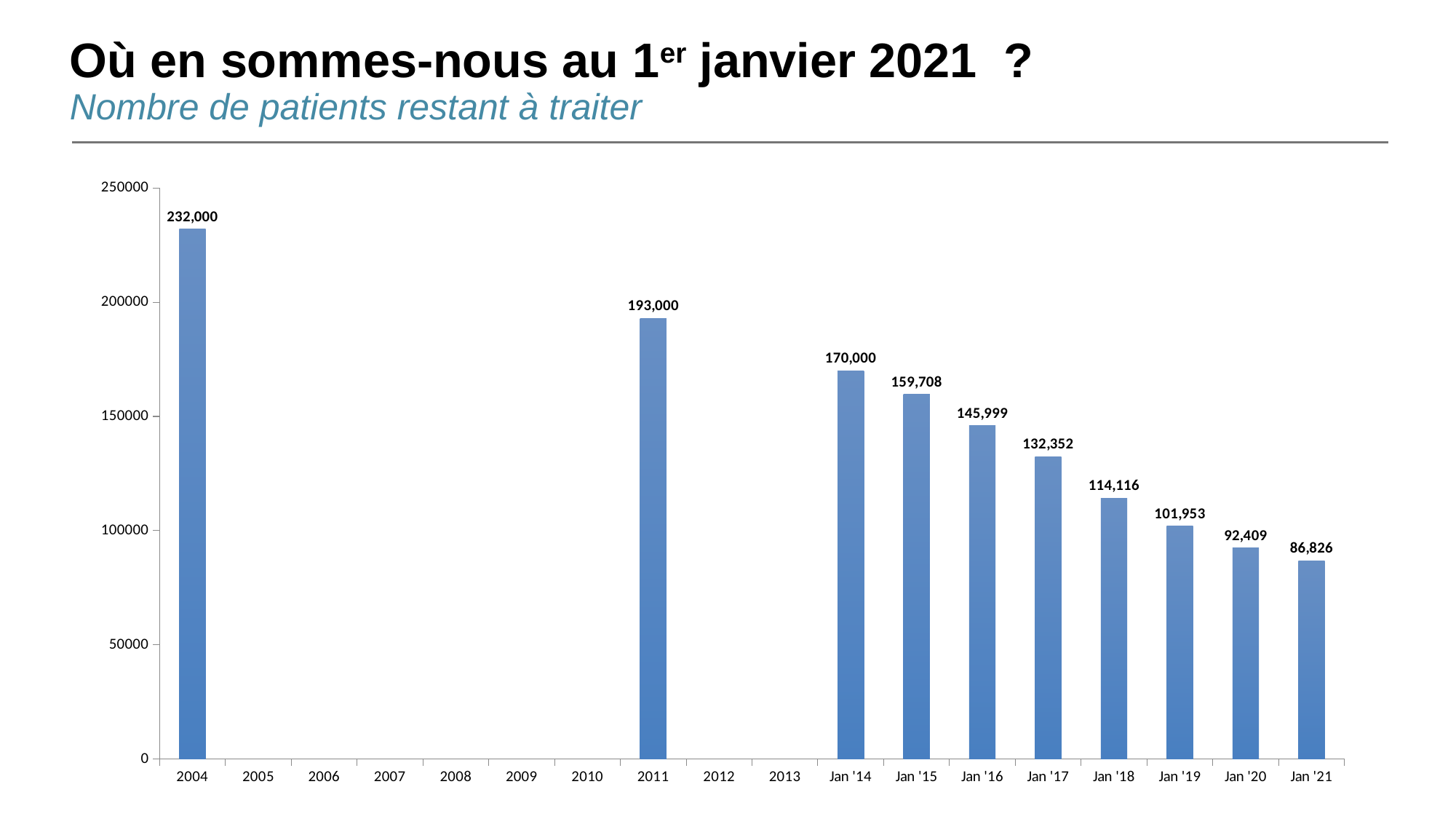
What is the value for Jan '21? 86,826 What is the value for Jan '17? 132,352 Which is larger, the value for Jan '18 or the value for Jan '19? Jan '18 Do the values rise or fall from Jan '14 to Jan '21? Fall How many bars are plotted on the chart? 10 Which category with a bar has the lowest value? Jan '21 What is the difference between the values for 2004 and Jan '21? 145,174 Which category has the highest value? 2004 What is the value for 2011? 193,000 What is the value for 2004? 232,000 What is the difference between the values for Jan '14 and Jan '15? 10,292 What kind of chart is shown on the slide? Bar chart